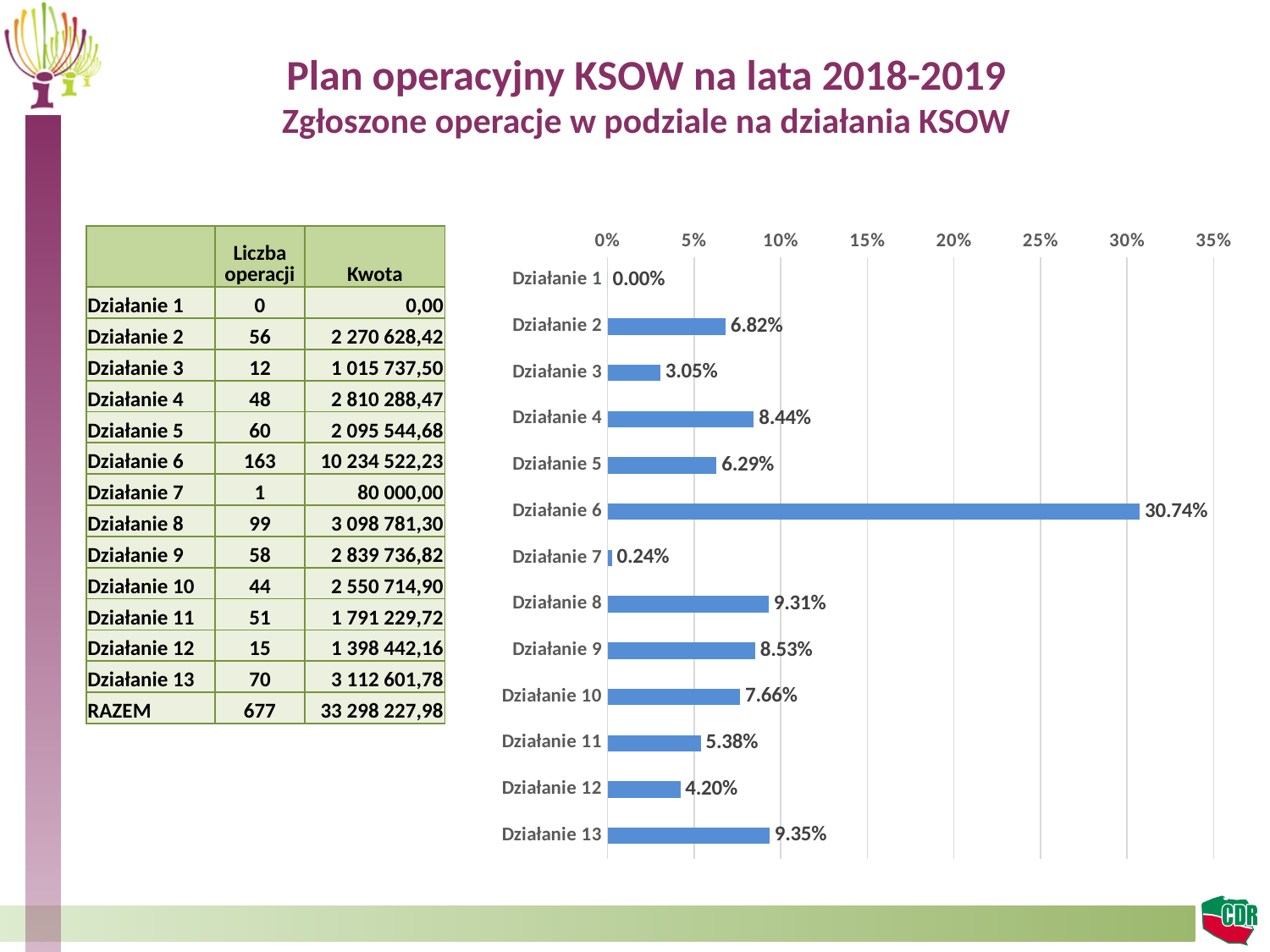
What is the value shown for Działanie 12 in the bar chart? 4.20% What is the value shown for Działanie 6 in the bar chart? 30.74% What kind of chart is shown on the slide? bar chart Which category has the highest value in the bar chart? Działanie 6 What is the value shown for Działanie 13 in the bar chart? 9.35% How many categories are shown in the bar chart? 13 Which has a larger value in the bar chart, Działanie 4 or Działanie 5? Działanie 4 What is the difference between the values for Działanie 8 and Działanie 2 in the bar chart? 2.49% Which category has the lowest value in the bar chart? Działanie 1 What is the value shown for Działanie 7 in the bar chart? 0.24% Is the value for Działanie 6 in the bar chart greater or less than 30%? greater What is the maximum value shown on the percentage axis of the bar chart? 35%